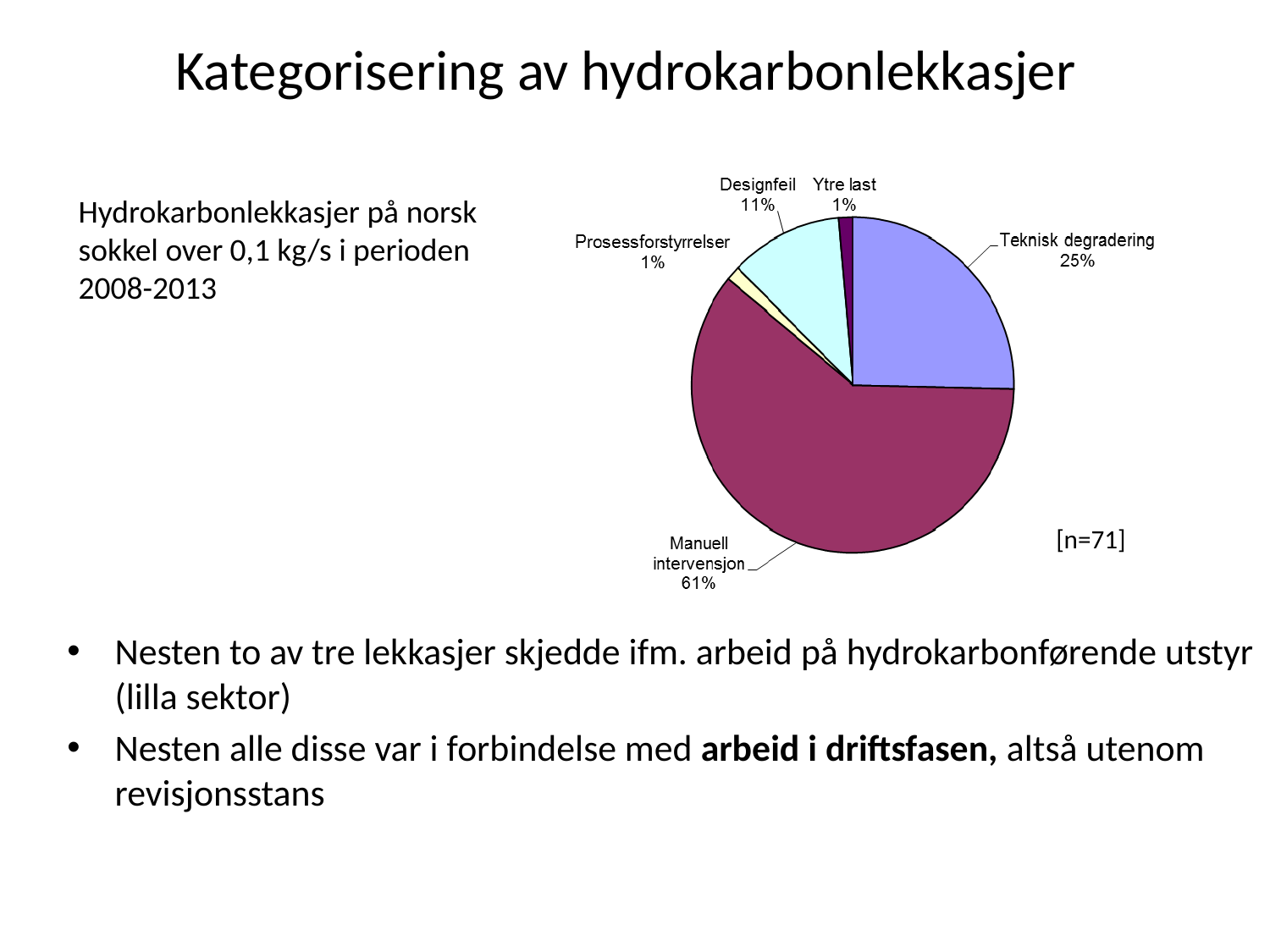
What percentage is shown for Ytre last? 1% Which is larger, the slice for Teknisk degradering or the slice for Designfeil? Teknisk degradering What is the difference in percentage points between Manuell intervensjon and Teknisk degradering? 36 percentage points What kind of chart is shown on the slide? pie chart What share of the pie does Designfeil account for? 11% What share of the pie does Teknisk degradering account for? 25% What sample size (n) is noted next to the pie chart? n=71 What percentage is shown for Prosessforstyrrelser? 1% How many slices does the pie chart have? 5 What is the difference in percentage points between Teknisk degradering and Designfeil? 14 percentage points Which category has the largest slice of the pie? Manuell intervensjon What share of the pie does Manuell intervensjon account for? 61%